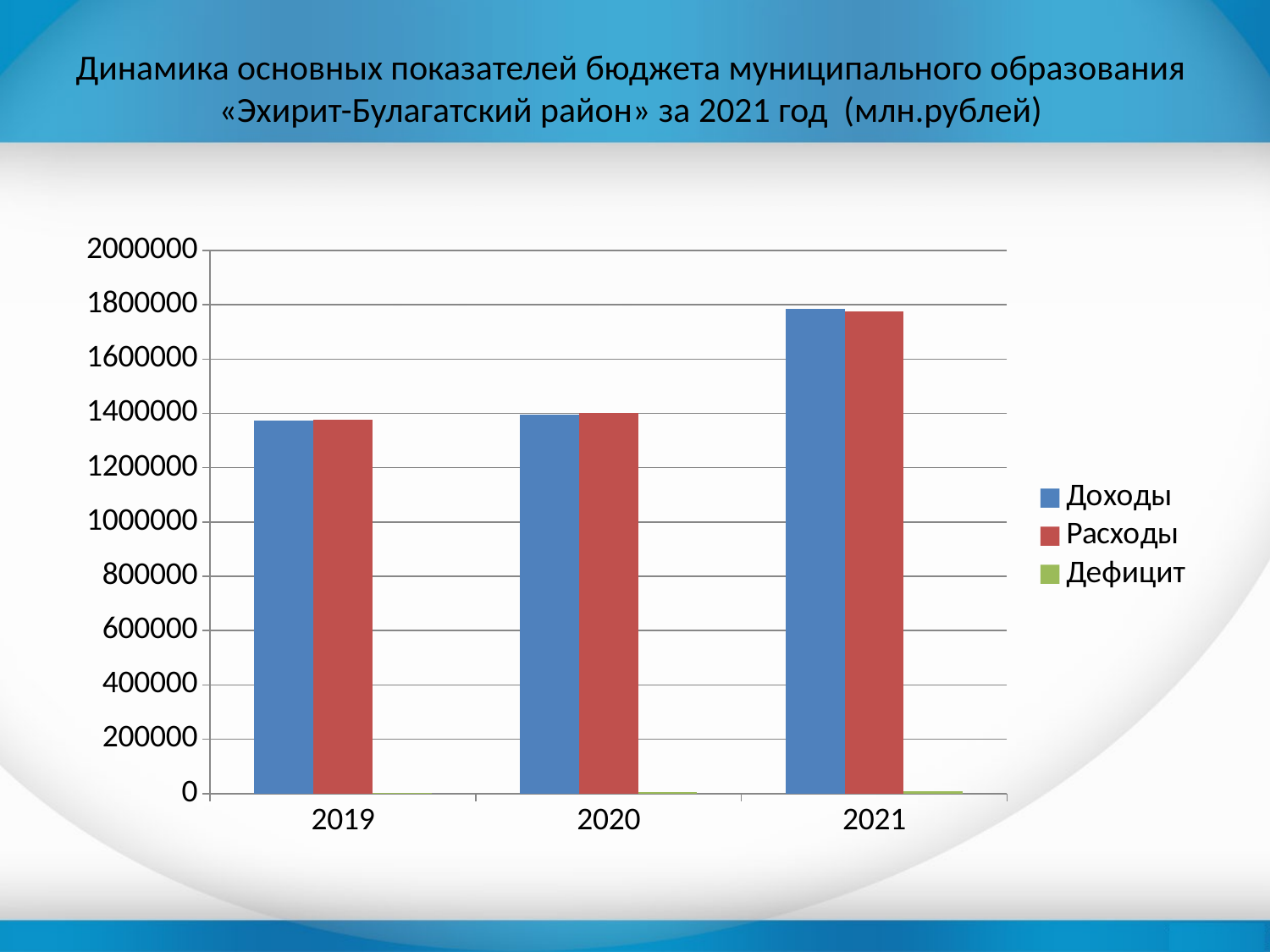
Is the value for Доходы in 2021 greater or less than 1600000? greater Is the value for Дефицит in 2021 greater or less than 200000? less How many series does the chart's legend list? 3 Which year has the highest value for Расходы? 2021 Which year has the highest value for Доходы? 2021 How many years are shown on the x axis of the chart? 3 Is the value for Расходы in 2019 greater or less than 1400000? less What kind of chart is shown on the slide? bar chart What colour represents Доходы in the chart's legend? blue Do the values for Доходы rise or fall from 2019 to 2021? rise Which is larger: Доходы in 2021 or Доходы in 2019? Доходы in 2021